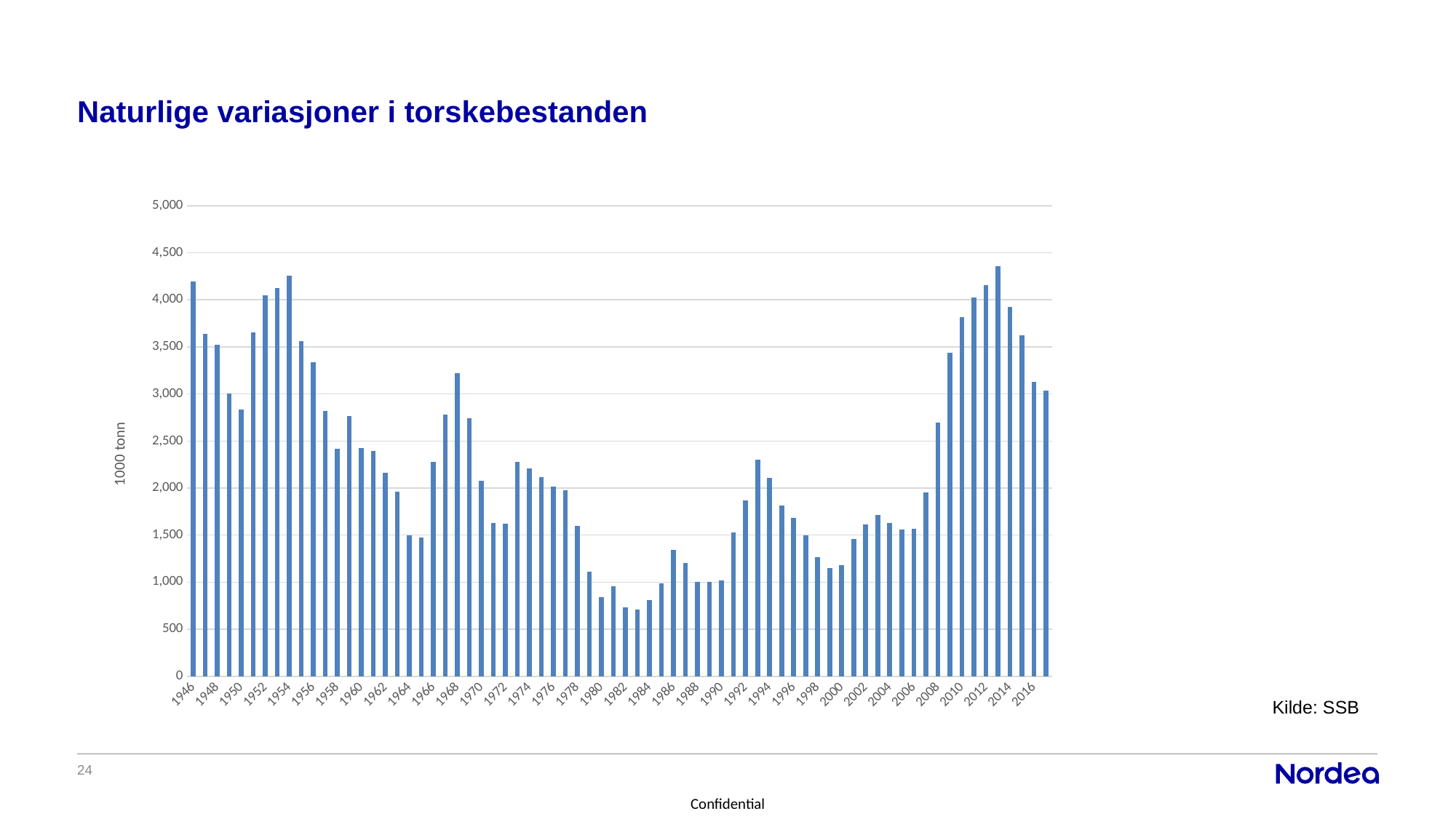
Is the value for 2000 greater or less than 1,500? less Which is larger, the value for 2002 or the value for 2012? 2012 Is the value for 1980 greater or less than 1,000? less What kind of chart is shown on the slide? bar chart Is the value for 1946 greater or less than 4,000? greater What is the label on the vertical axis of the chart? 1000 tonn Which is larger, the value for 1946 or the value for 1950? 1946 Do the values generally rise or fall from 2006 to 2013? rise Which year has the highest bar in the chart? 2013 What is the title of the chart? Naturlige variasjoner i torskebestanden